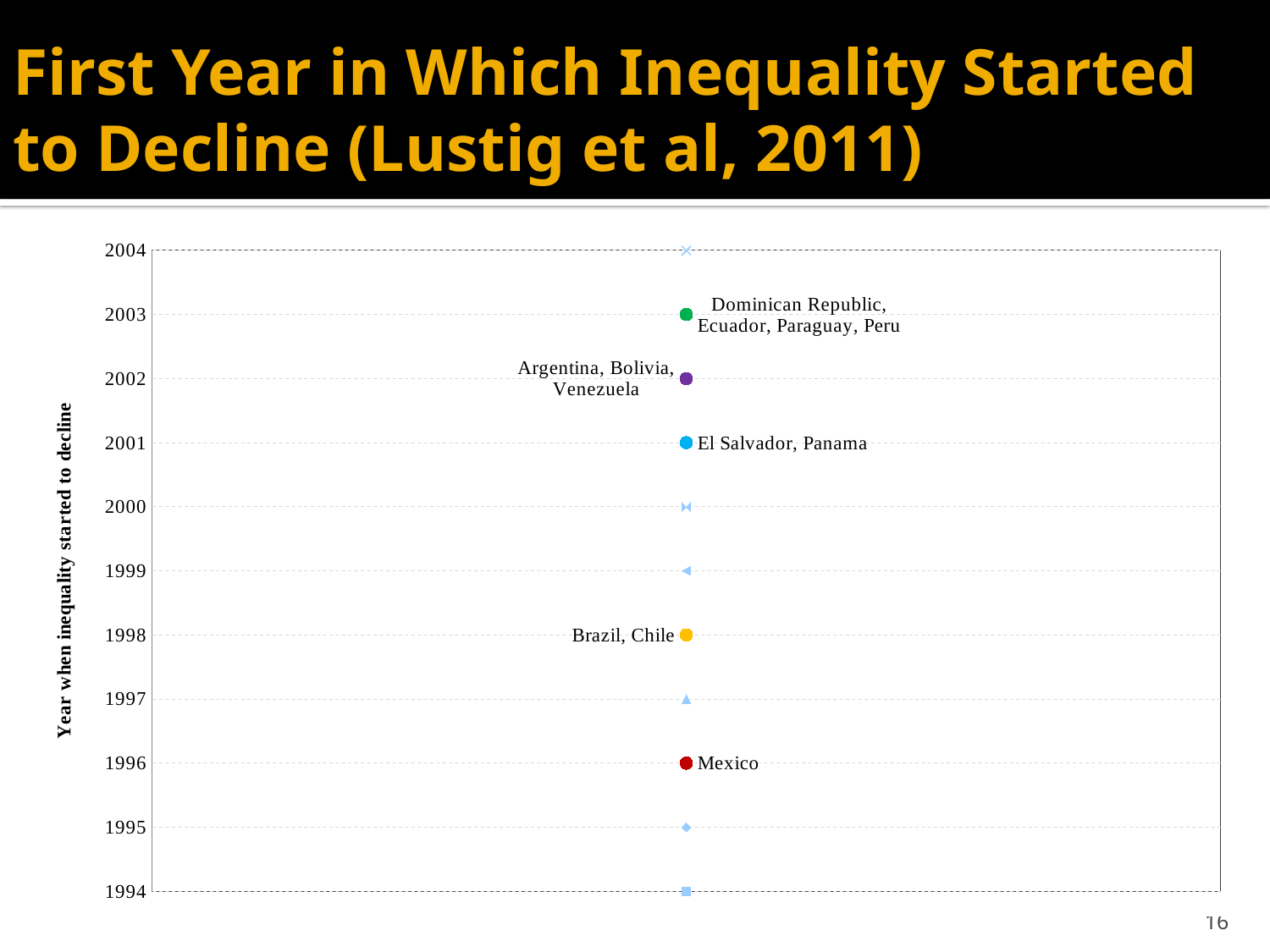
In which year did inequality start to decline in Mexico? 1996 What is the label on the vertical axis of the chart? Year when inequality started to decline In which year did inequality start to decline in El Salvador and Panama? 2001 Which labelled country has the earliest year in which inequality started to decline? Mexico How many years separate the start of the decline in the Dominican Republic, Ecuador, Paraguay and Peru from that in Brazil and Chile? 5 years Which started to see inequality decline later: Argentina, Bolivia and Venezuela, or El Salvador and Panama? Argentina, Bolivia, Venezuela Which labelled country group has the latest year in which inequality started to decline? Dominican Republic, Ecuador, Paraguay, Peru In which year did inequality start to decline in Argentina, Bolivia and Venezuela? 2002 In which year did inequality start to decline in the Dominican Republic, Ecuador, Paraguay and Peru? 2003 In which year did inequality start to decline in Brazil and Chile? 1998 How many labelled country groups are shown on the chart? 5 How many years later did inequality start to decline in Brazil and Chile than in Mexico? 2 years